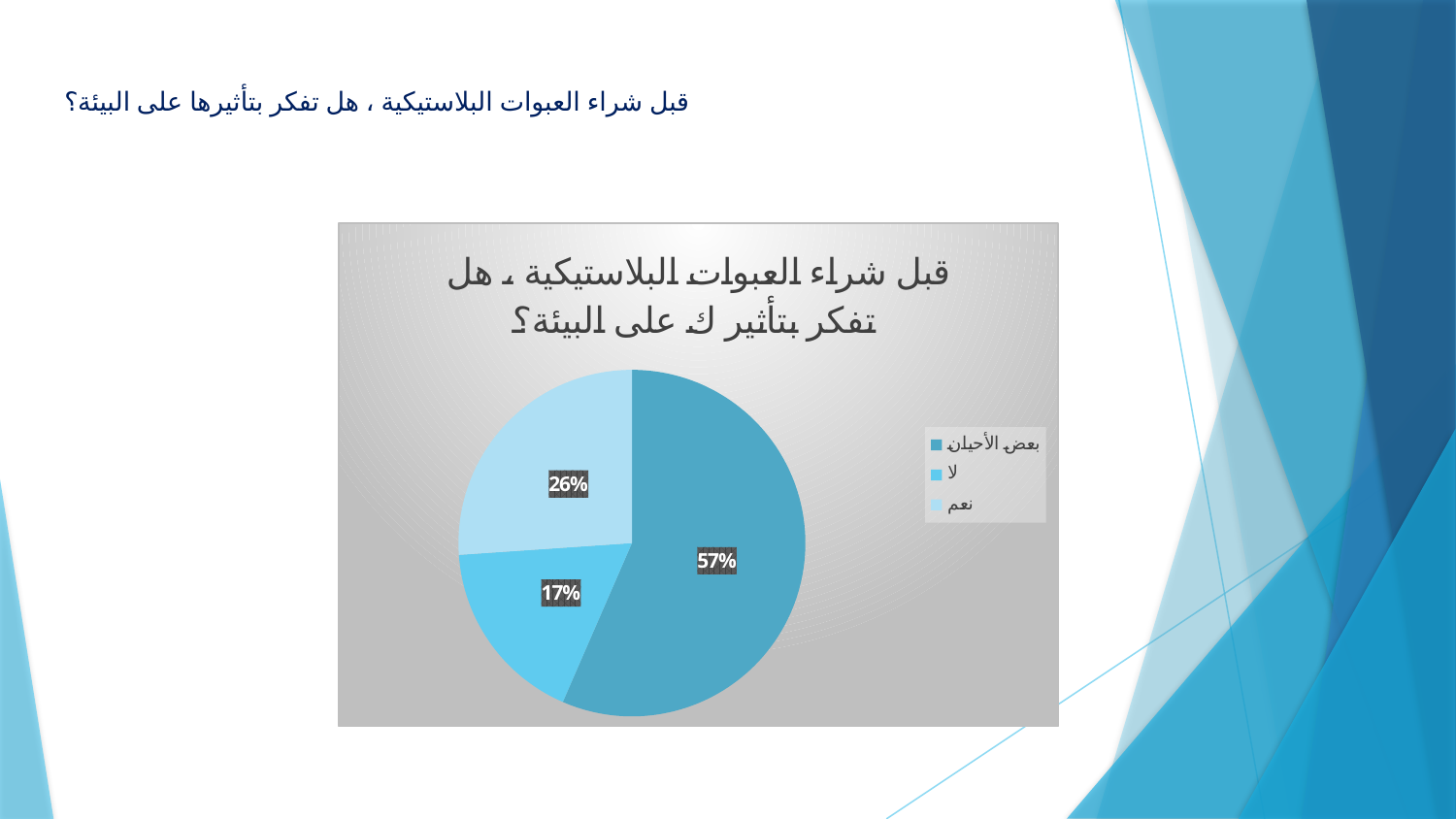
What is the difference in percentage points between "بعض الأحيان" and "نعم"? 31 Which legend entry is shown in the lightest blue colour? نعم What share of the pie does "نعم" have? 26% What kind of chart is shown on the slide? pie chart Which is larger, the slice for "نعم" or the slice for "لا"? نعم Which category has the largest slice of the pie? بعض الأحيان What share of the pie does "لا" have? 17% How many entries does the legend list? 3 What share of the pie does "بعض الأحيان" have? 57% What is the difference in percentage points between "نعم" and "لا"? 9 How many slices does the pie chart have? 3 Which category has the smallest slice of the pie? لا